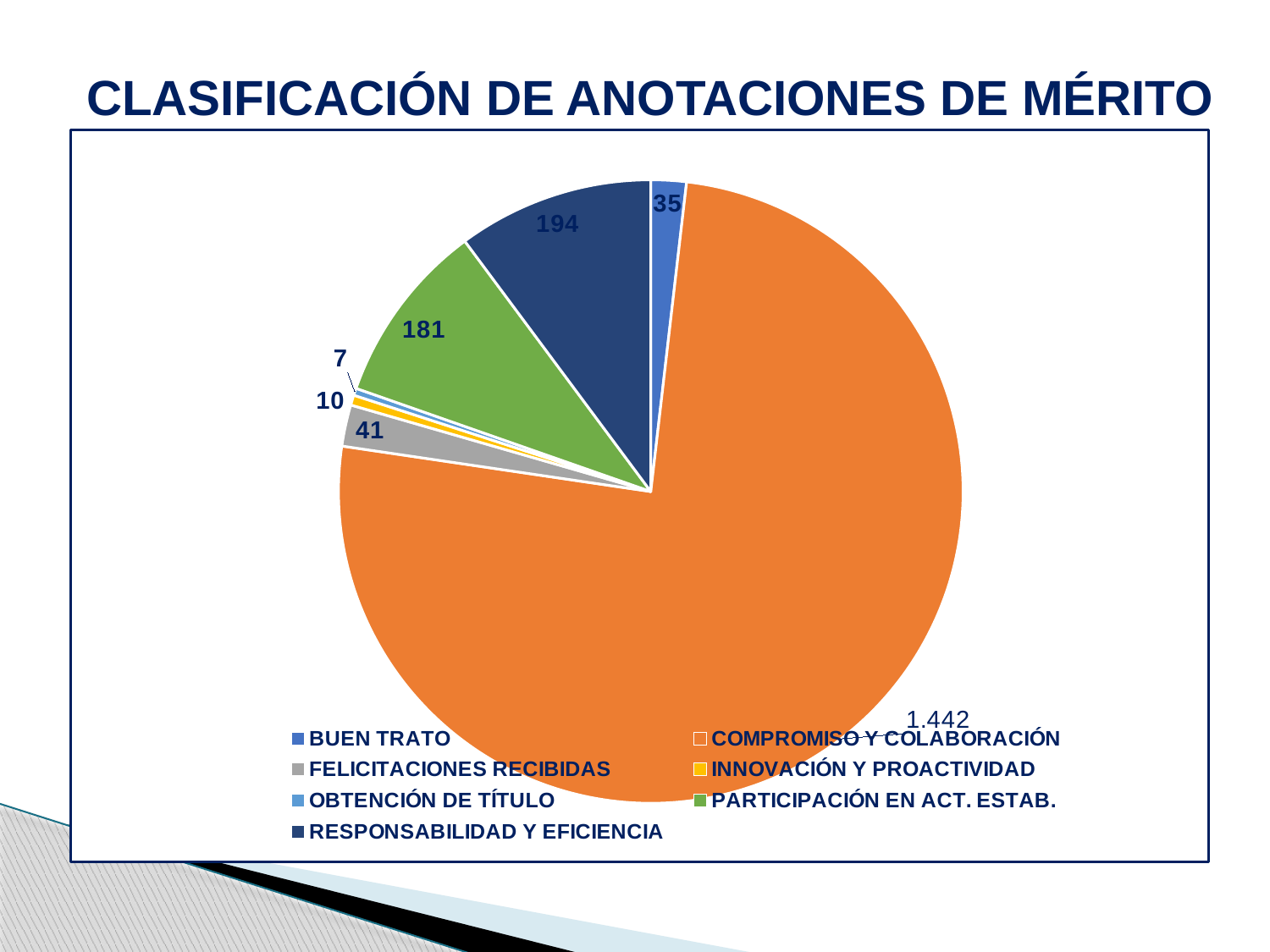
Which is larger, the value for FELICITACIONES RECIBIDAS or the value for BUEN TRATO? FELICITACIONES RECIBIDAS What value is shown for FELICITACIONES RECIBIDAS? 41 What value is shown for PARTICIPACIÓN EN ACT. ESTAB.? 181 Which category has the smallest slice of the pie? OBTENCIÓN DE TÍTULO What is the difference between the values for RESPONSABILIDAD Y EFICIENCIA and PARTICIPACIÓN EN ACT. ESTAB.? 13 What value is shown for COMPROMISO Y COLABORACIÓN? 1.442 What value is shown for OBTENCIÓN DE TÍTULO? 7 Which category has the largest slice of the pie? COMPROMISO Y COLABORACIÓN What is the title of the slide? CLASIFICACIÓN DE ANOTACIONES DE MÉRITO How many categories does the pie chart show? 7 What kind of chart is shown on the slide? Pie chart What value is shown for RESPONSABILIDAD Y EFICIENCIA? 194